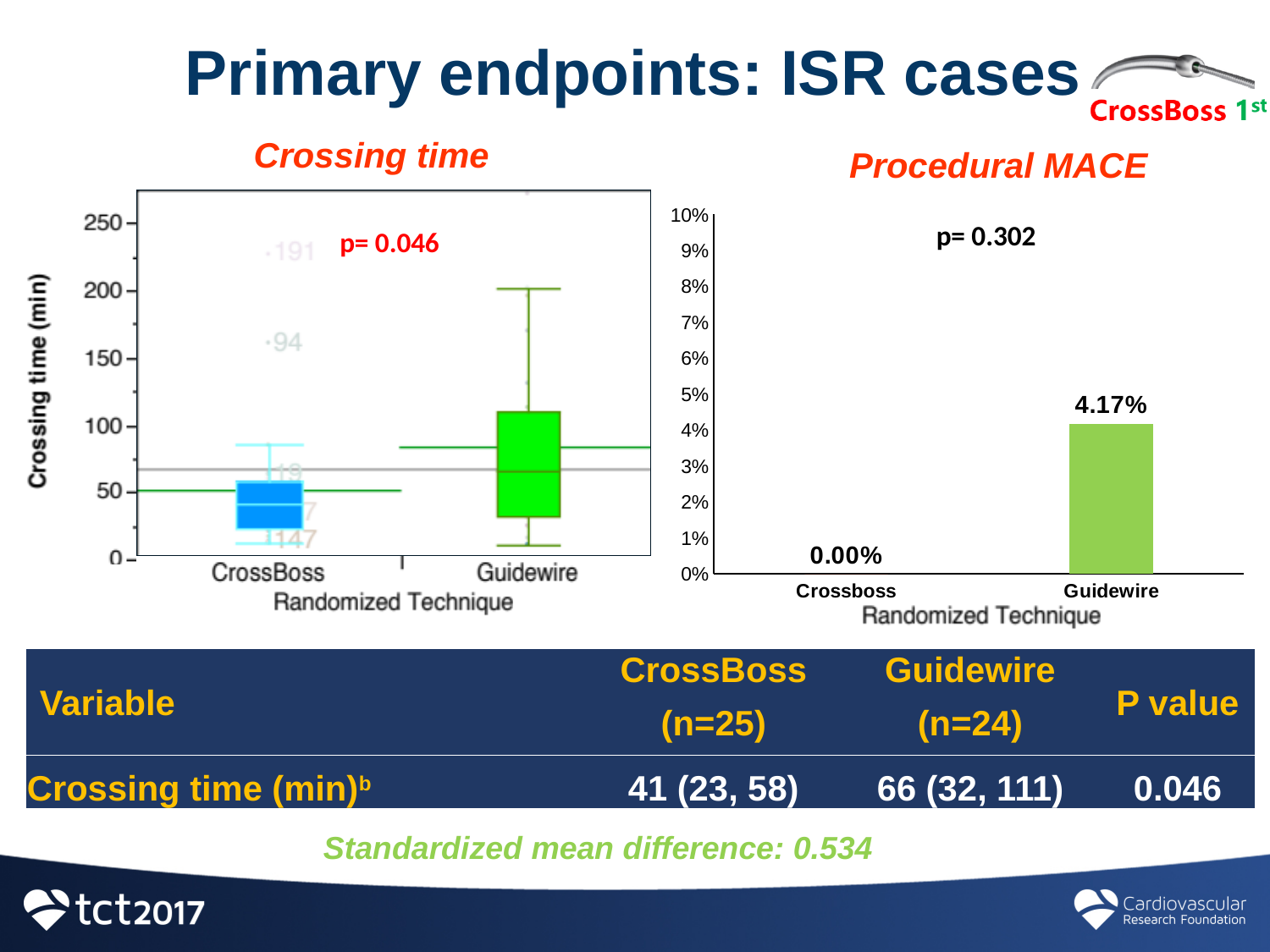
In the Procedural MACE chart, what is the value for Guidewire? 4.17% In the Crossing time chart, is the top whisker for Guidewire greater or less than 150 minutes? greater In the Procedural MACE chart, which technique has the higher procedural MACE rate? Guidewire What kind of chart is the Crossing time chart? Box plot In the Procedural MACE chart, what is the value for Crossboss? 0.00% What is the y-axis label of the Crossing time chart? Crossing time (min) In the Procedural MACE chart, what is the difference between the Guidewire and Crossboss values? 4.17% In the Crossing time chart, which technique has the higher median crossing time? Guidewire What p value is shown on the Procedural MACE chart? p= 0.302 In the Procedural MACE chart, how many techniques are plotted on the x axis? 2 In the Procedural MACE chart, is the value for Guidewire greater or less than 5%? less What kind of chart is the Procedural MACE chart? Bar chart